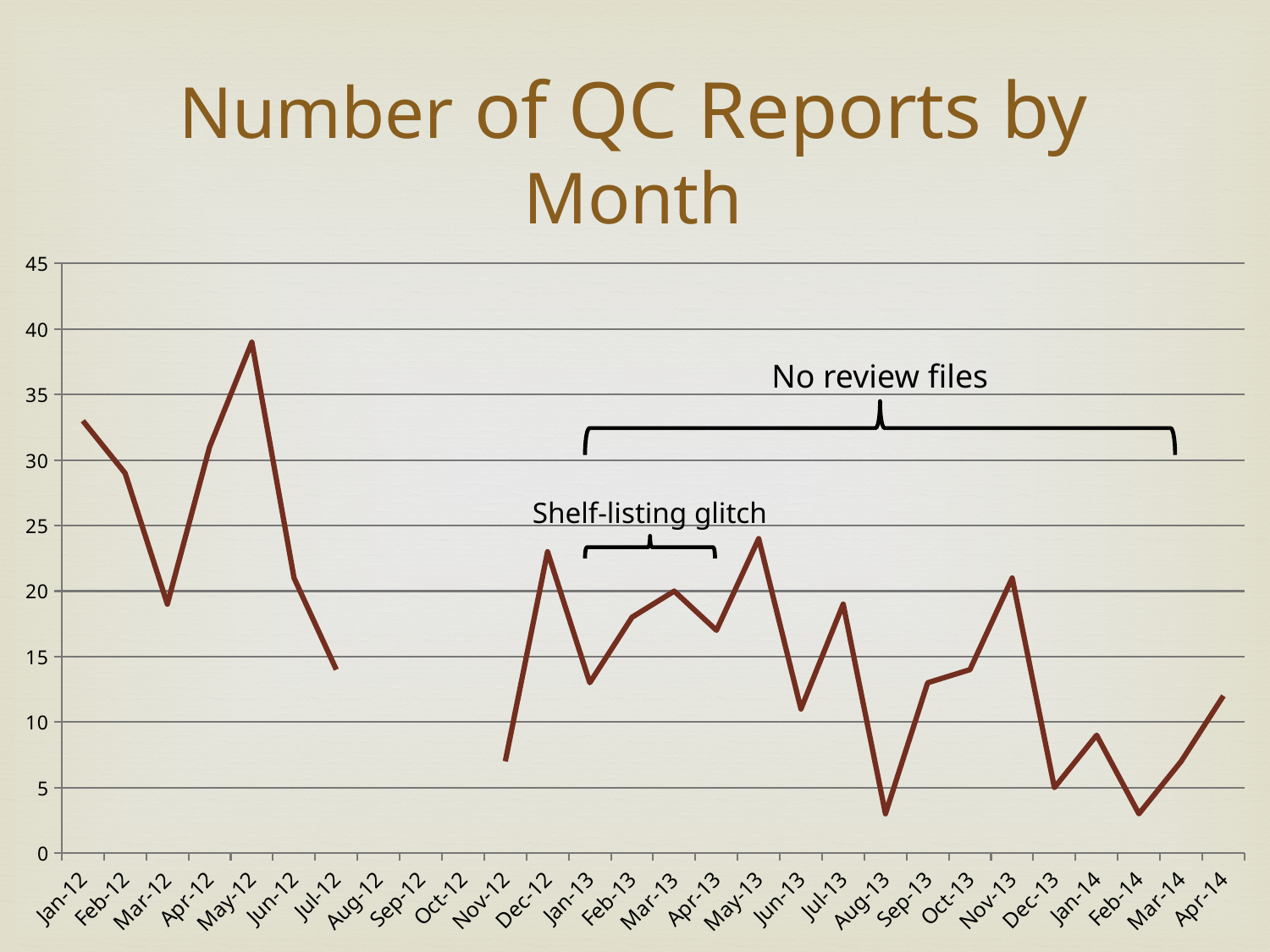
Is the value for May-13 greater or less than 20? greater Is the value for Nov-12 greater or less than 10? less Is the value for Jan-12 greater or less than 30? greater What is the title of the chart? Number of QC Reports by Month How many month labels are shown on the x axis? 28 What does the annotation above the long bracket on the right side of the chart say? No review files Do the values rise or fall from Jan-12 to Mar-12? Fall Which is larger, the value for May-12 or the value for Dec-12? May-12 Which month has the highest number of QC reports? May-12 What kind of chart is shown on the slide? Line chart